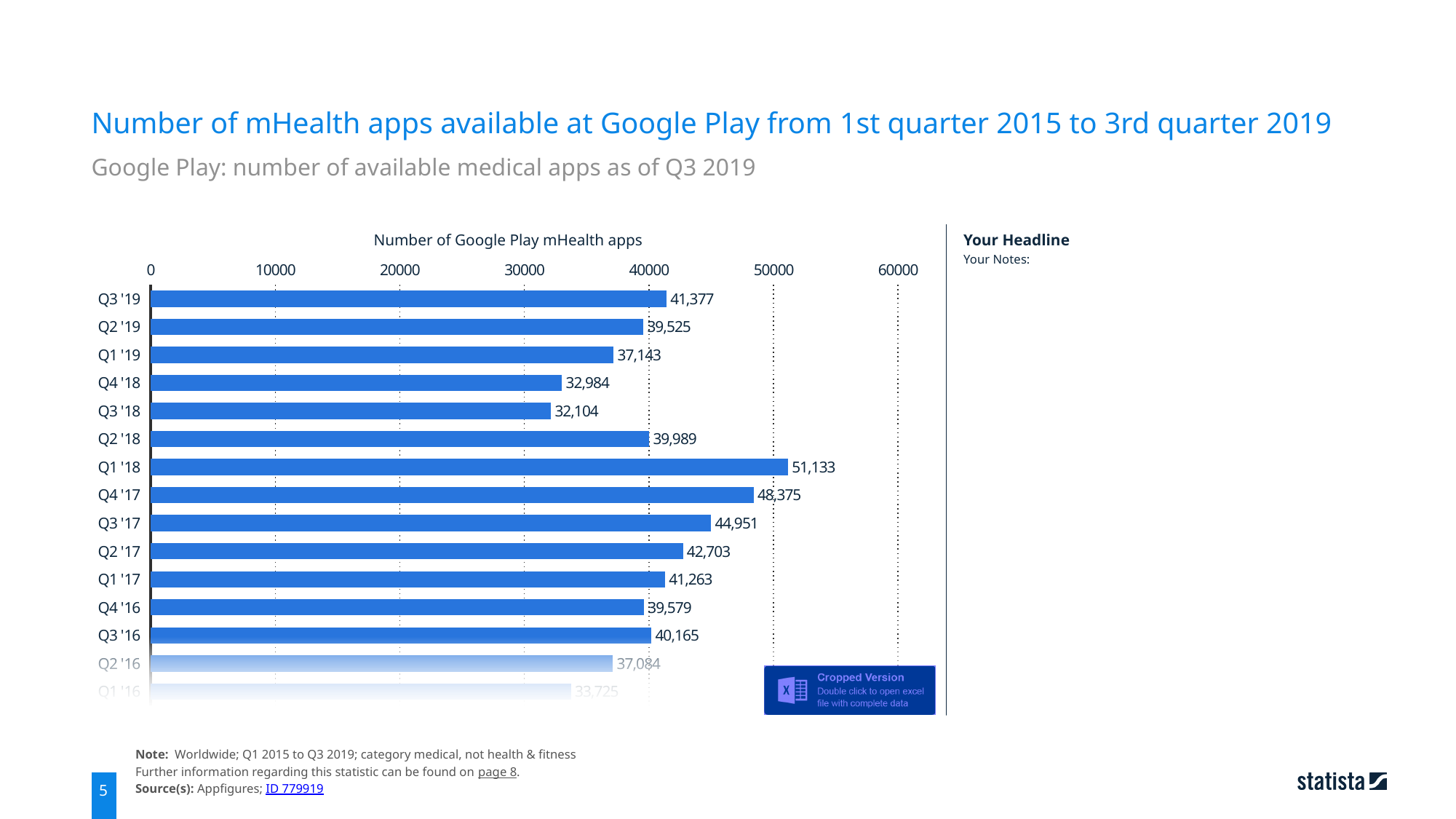
What is the difference between the values for Q3 '19 and Q2 '19? 1,852 What is the title of the horizontal axis of the chart? Number of Google Play mHealth apps How many mHealth apps were available on Google Play in Q3 '19? 41,377 Which quarter has the lowest number of mHealth apps? Q3 '18 What type of chart is shown on the slide? Bar chart What is the difference between the values for Q1 '18 and Q4 '17? 2,758 Which quarter has the highest number of mHealth apps? Q1 '18 What is the value shown for Q4 '17? 48,375 What is the value shown for Q3 '18? 32,104 Do the values rise or fall from Q1 '18 to Q3 '18? fall Is the value for Q1 '18 greater or less than 50000? greater Which is larger, the value for Q2 '17 or the value for Q1 '17? Q2 '17